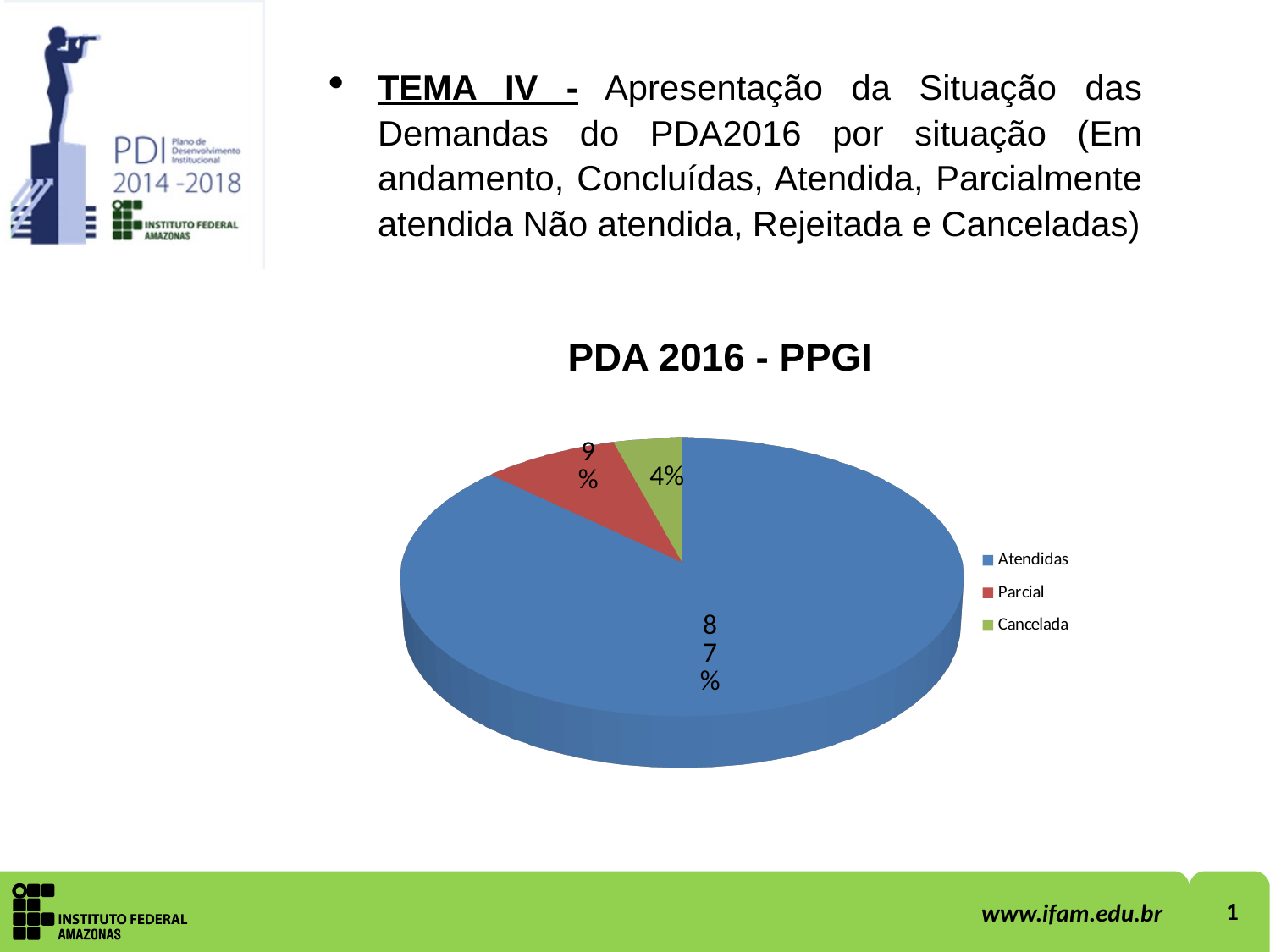
What percentage of the pie is labelled for Cancelada? 4% How many slices does the pie chart have? 3 What colour is the Cancelada slice in the pie chart? green What percentage of the pie is labelled for Atendidas? 87% What is the difference in percentage points between the Atendidas slice and the Parcial slice? 78 Which category has the smallest slice of the pie? Cancelada What kind of chart is shown under the title "PDA 2016 - PPGI"? pie chart What percentage of the pie is labelled for Parcial? 9% Which slice is larger, Parcial or Cancelada? Parcial What is the title of the chart? PDA 2016 - PPGI Which category has the largest slice of the pie? Atendidas How many entries does the legend list? 3